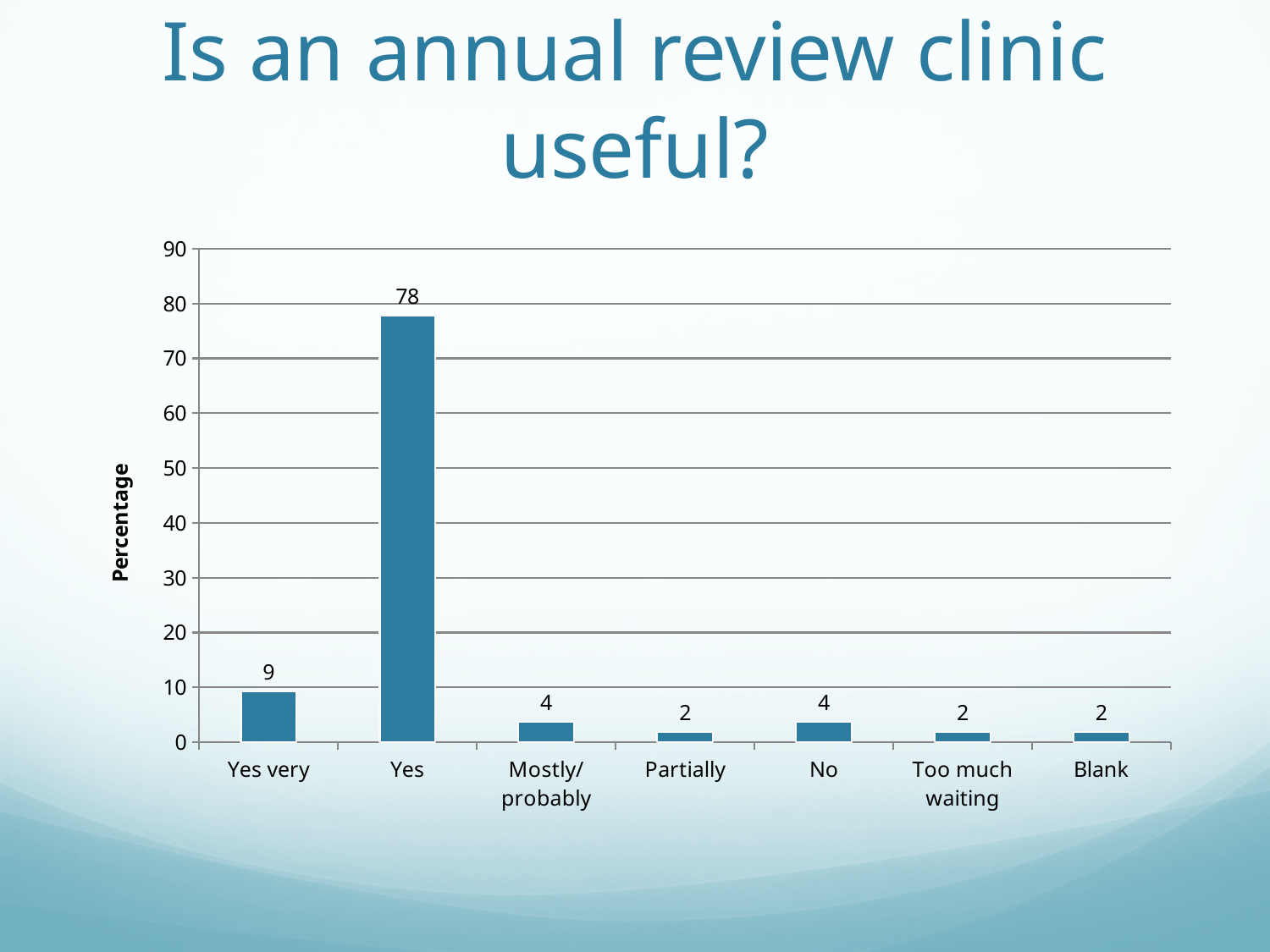
What is the value for "Yes very"? 9 What is the difference between the values for "Mostly/probably" and "Partially"? 2 What is the difference between the values for "Yes" and "Yes very"? 69 What is the value for "Yes"? 78 What is the value for "Too much waiting"? 2 How many categories are shown on the x axis? 7 What is the value for "No"? 4 What is the label of the vertical axis? Percentage Which category has the highest value? Yes Which is larger, the value for "Yes very" or the value for "No"? Yes very Is the value for "Yes" greater or less than 70? greater What kind of chart is shown on the slide? Bar chart